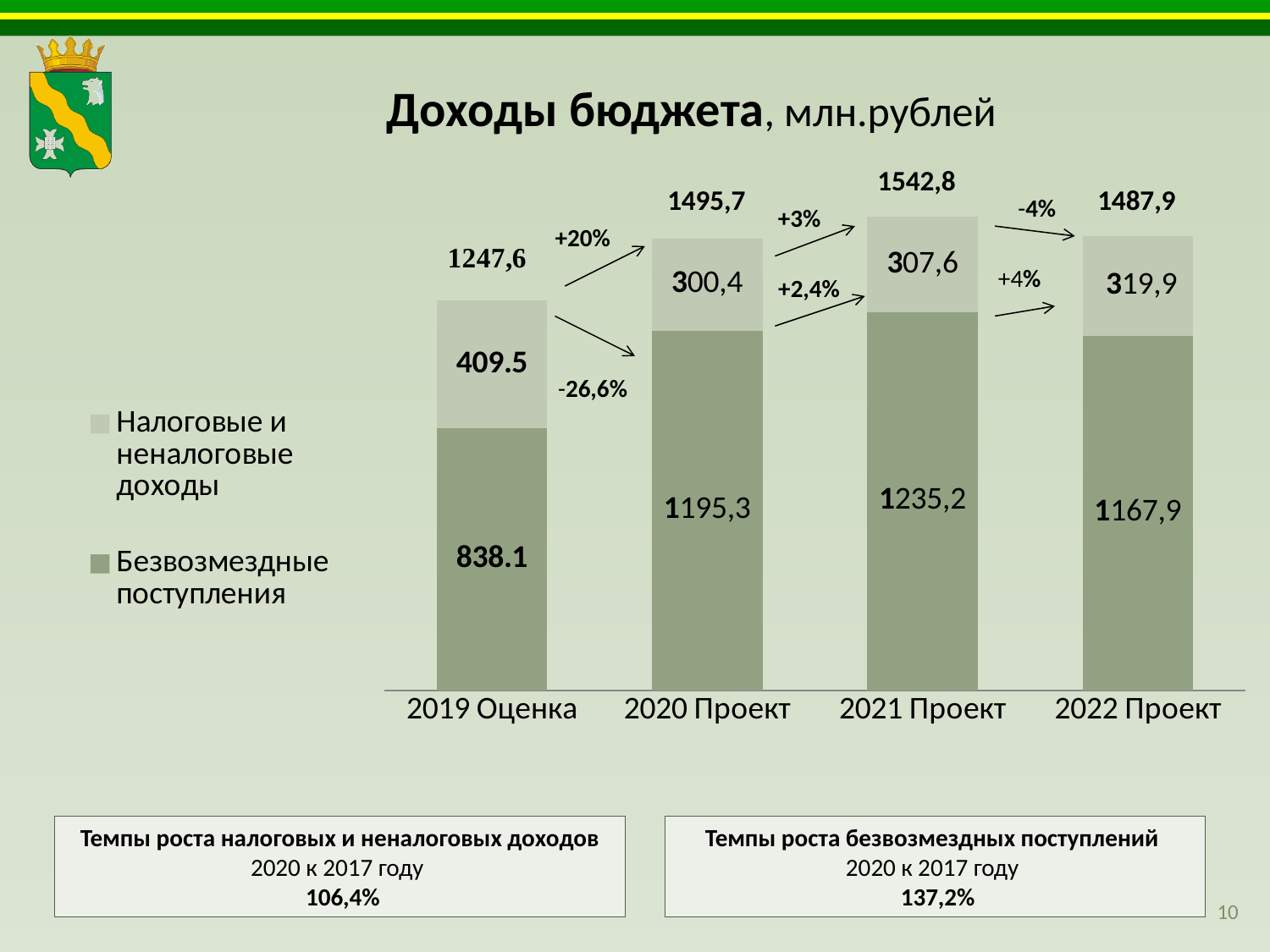
What is the value of Налоговые и неналоговые доходы for 2020 Проект? 300,4 Which is larger: Безвозмездные поступления for 2020 Проект or for 2022 Проект? 2020 Проект What is the total of the stacked bar for 2022 Проект? 1487,9 How many categories are shown on the x axis of the chart? 4 Which category has the lowest total budget revenue? 2019 Оценка Which category has the highest total budget revenue? 2021 Проект How many series does the legend list? 2 What is the value of Безвозмездные поступления for 2021 Проект? 1235,2 What is the title of the chart? Доходы бюджета, млн.рублей What kind of chart is shown on the slide? stacked bar chart What is the difference between the total for 2020 Проект and the total for 2019 Оценка? 248,1 What is the value of Безвозмездные поступления for 2019 Оценка? 838.1